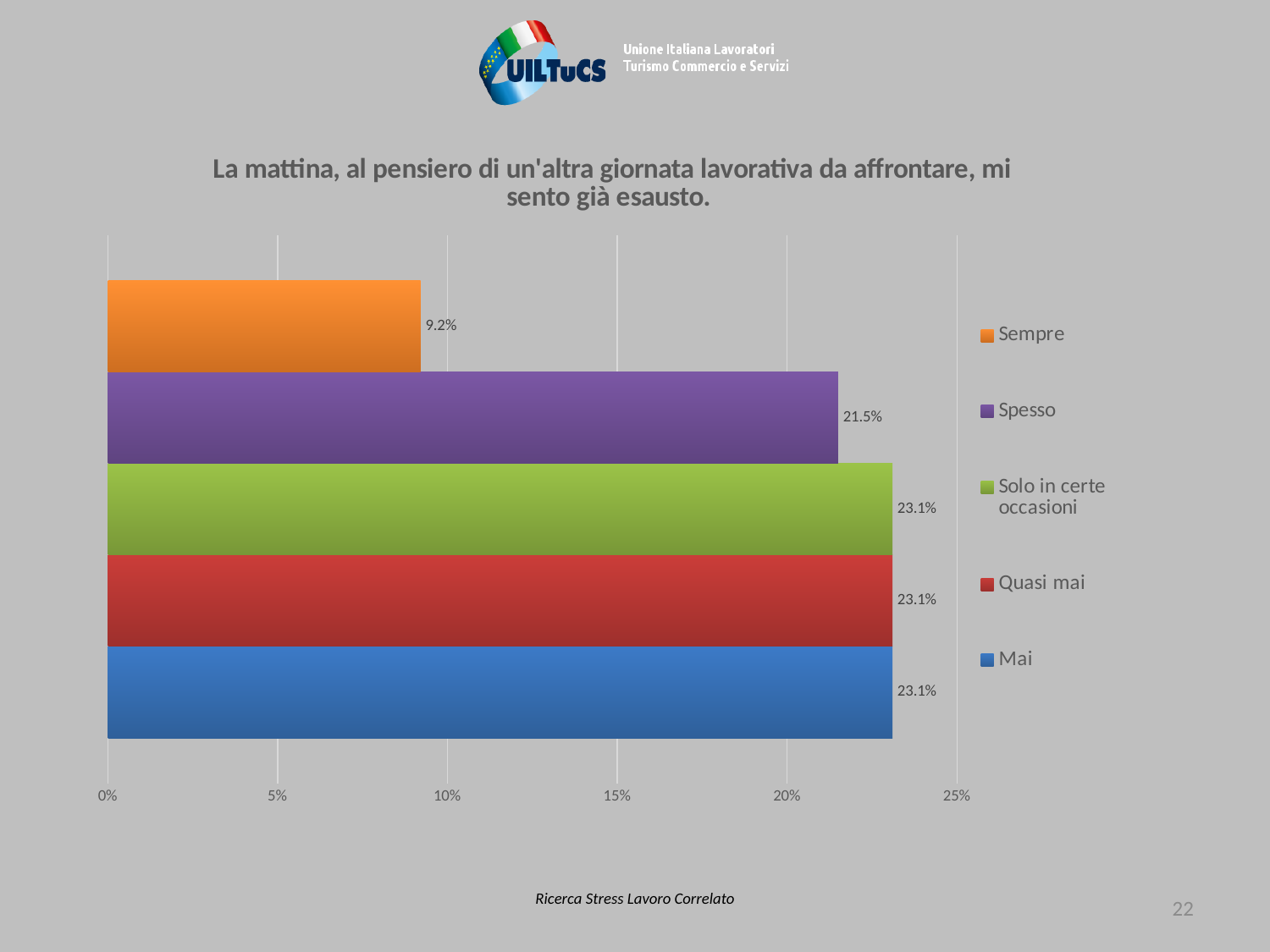
What is the value for Sempre? 9.2% Is the value for Sempre greater or less than 10%? less Which category has the lowest value? Sempre What is the value for Spesso? 21.5% What colour is the bar for Solo in certe occasioni? green What is the value for Quasi mai? 23.1% How many categories are shown in the chart? 5 What kind of chart is shown on the slide? bar chart Which is larger, the value for Spesso or the value for Sempre? Spesso Is the value for Spesso greater or less than 20%? greater What is the value for Mai? 23.1% What is the difference between the values for Spesso and Sempre? 12.3%